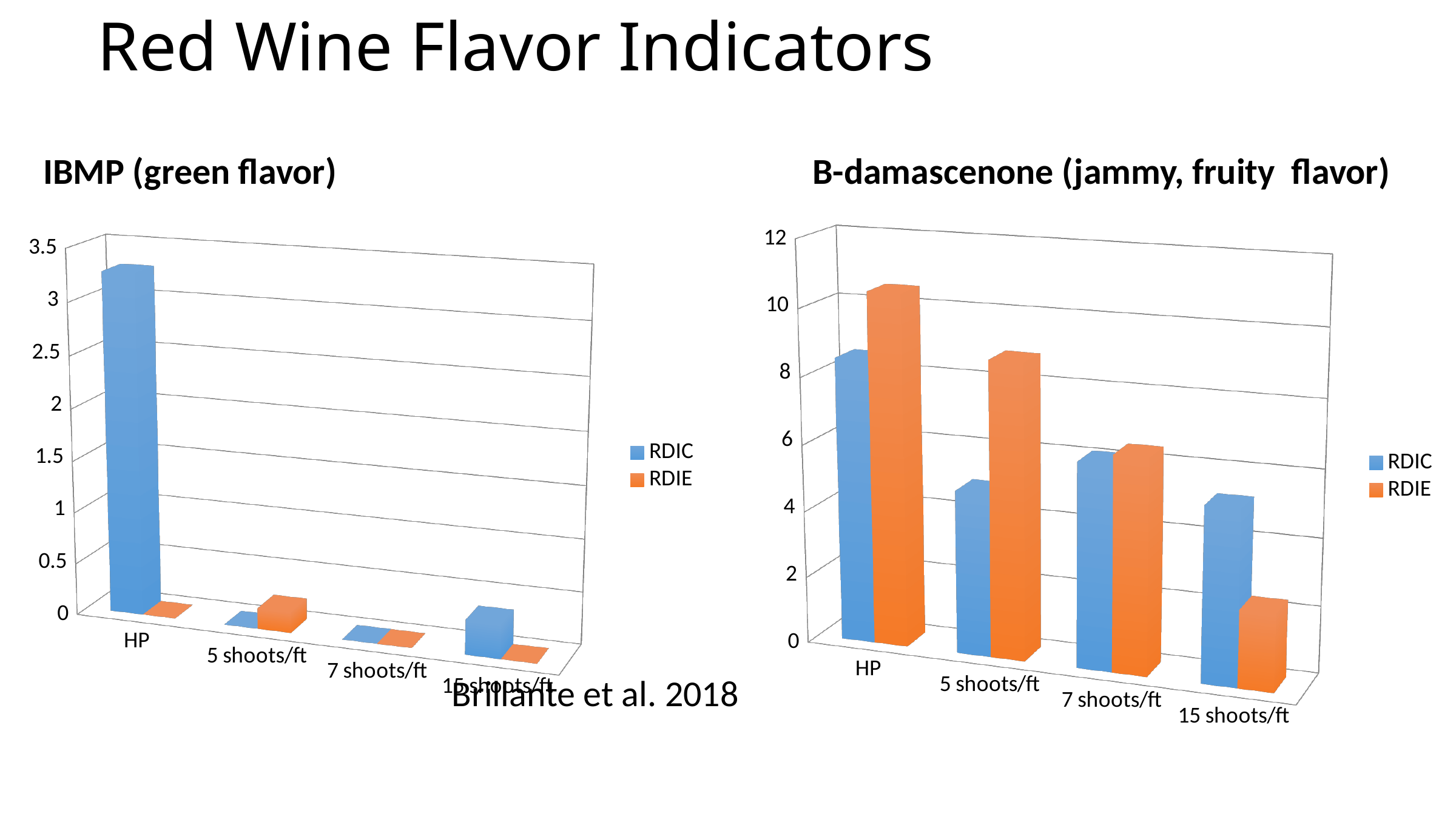
How many categories are shown on the x axis of the B-damascenone (jammy, fruity flavor) chart? 4 How many series does the legend of the B-damascenone (jammy, fruity flavor) chart list? 2 In the B-damascenone (jammy, fruity flavor) chart, which category has the highest RDIE value? HP In the B-damascenone (jammy, fruity flavor) chart, is the RDIE value for HP greater or less than 8? greater In the IBMP (green flavor) chart, which category has the highest RDIC value? HP What colour represents the RDIE series in the legend of the IBMP (green flavor) chart? orange In the IBMP (green flavor) chart, is the RDIC value for HP greater or less than 2.5? greater In the B-damascenone (jammy, fruity flavor) chart, do the RDIE values rise or fall from HP to 15 shoots/ft? fall What kind of chart is the IBMP (green flavor) chart? bar chart In the B-damascenone (jammy, fruity flavor) chart, which is larger at 5 shoots/ft, RDIC or RDIE? RDIE In the B-damascenone (jammy, fruity flavor) chart, which category has the lowest RDIE value? 15 shoots/ft